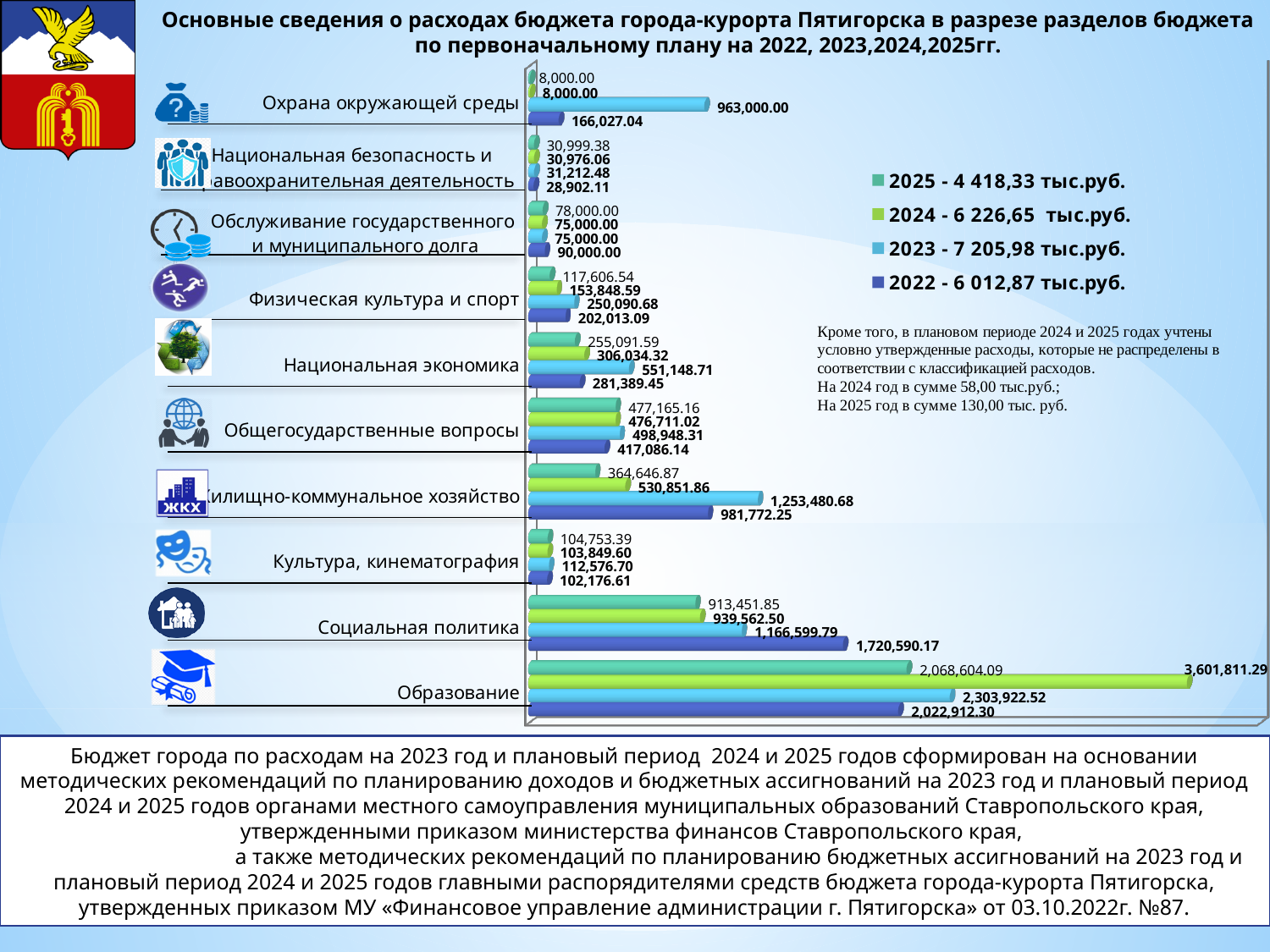
How many categories are shown on the chart? 10 Which category has the lowest value in the 2022 series? Национальная безопасность и правоохранительная деятельность Which is larger for Социальная политика: the 2022 value or the 2023 value? 2022 Which category has the highest value in the 2023 series? Образование What is the value for Охрана окружающей среды in the 2023 series? 963,000.00 What is the difference between the 2024 and 2023 values for Образование? 1,297,888.77 How many series does the legend list? 4 What kind of chart is shown on the slide? Bar chart What is the value for Образование in the 2024 series? 3,601,811.29 What is the value for Жилищно-коммунальное хозяйство in the 2023 series? 1,253,480.68 What is the difference between the 2022 and 2025 values for Обслуживание государственного и муниципального долга? 12,000.00 What is the value for Социальная политика in the 2022 series? 1,720,590.17